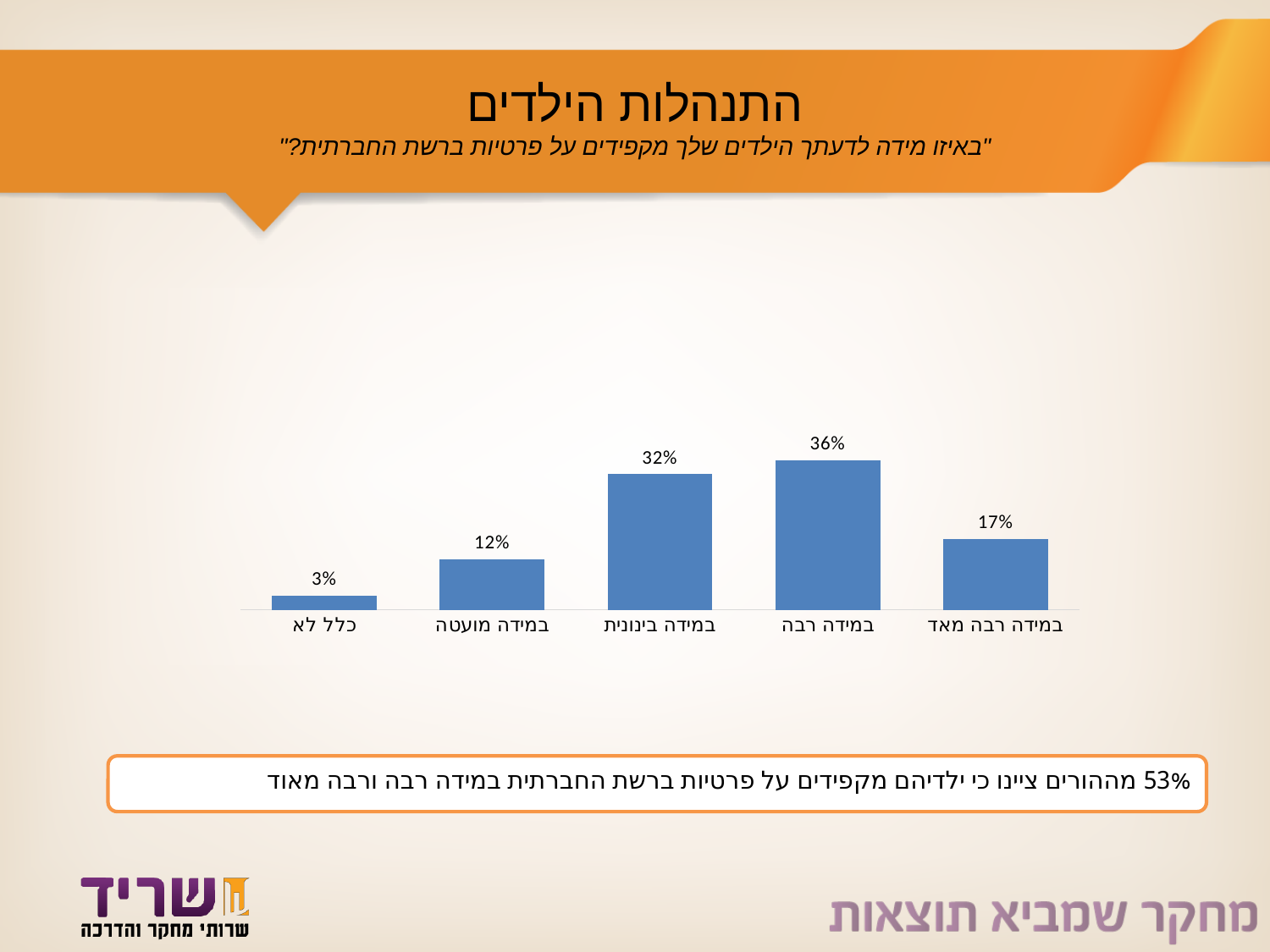
What value is shown for the category "במידה רבה מאד"? 17% Which category has the lowest value? כלל לא What value is shown for the category "במידה מועטה"? 12% What value is shown for the category "במידה רבה"? 36% What value is shown for the category "כלל לא"? 3% What is the difference between the values for "במידה רבה" and "במידה בינונית"? 4% How many categories are shown in the chart? 5 What is the difference between the values for "במידה רבה מאד" and "במידה מועטה"? 5% Which category has the highest value? במידה רבה What is the combined value of "במידה רבה" and "במידה רבה מאד"? 53% What kind of chart is shown on the slide? Bar chart Which is larger, the value for "במידה בינונית" or the value for "במידה רבה מאד"? במידה בינונית